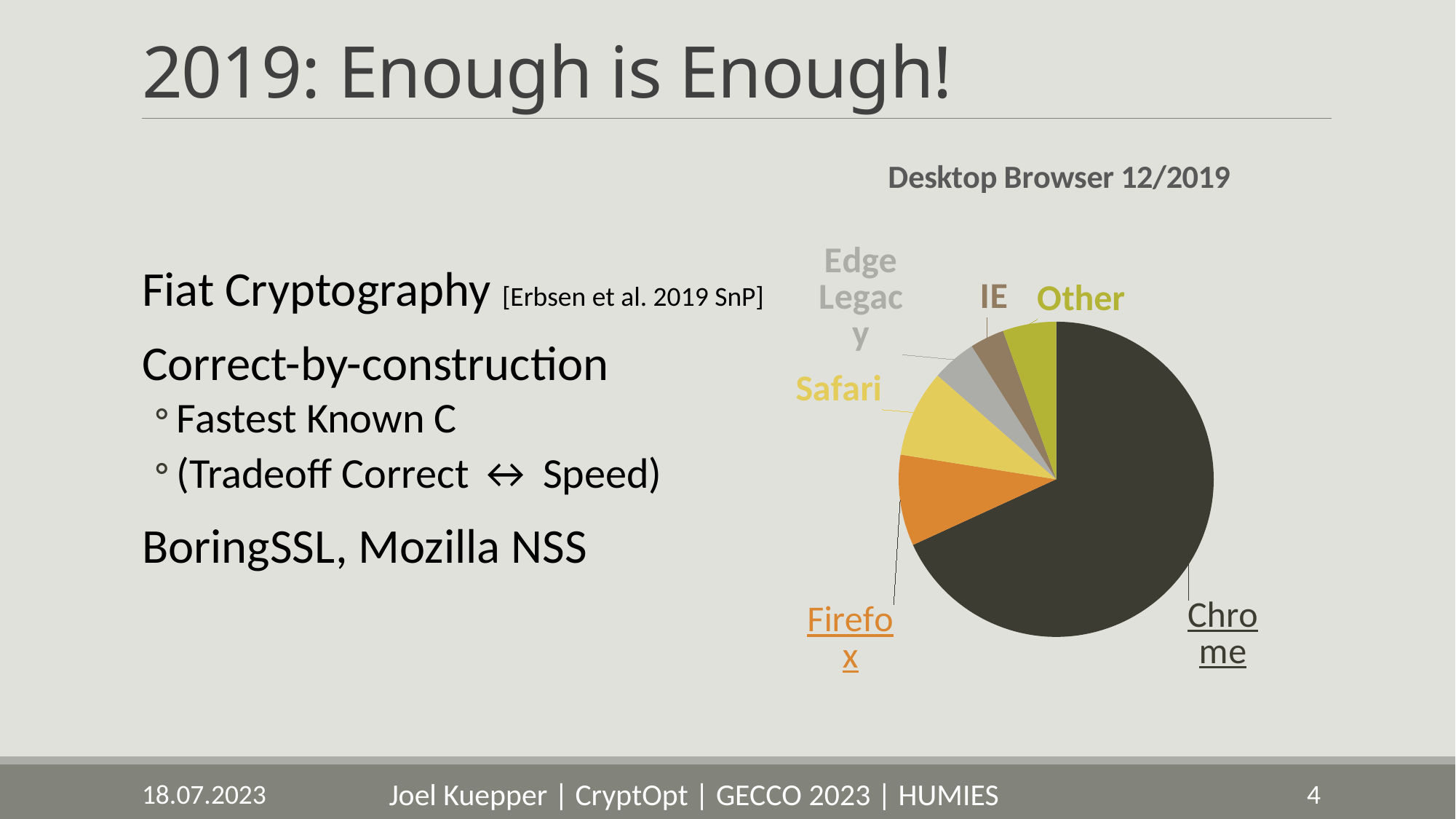
What kind of chart is shown on the slide? Pie chart Which slice is larger, Safari or IE? Safari What is the title of the pie chart? Desktop Browser 12/2019 Which slice is larger, Firefox or Edge Legacy? Firefox Which browser has the largest slice in the pie chart? Chrome Which slice is larger, Safari or Edge Legacy? Safari How many slices does the pie chart have? 6 Which browser is represented by the orange slice? Firefox